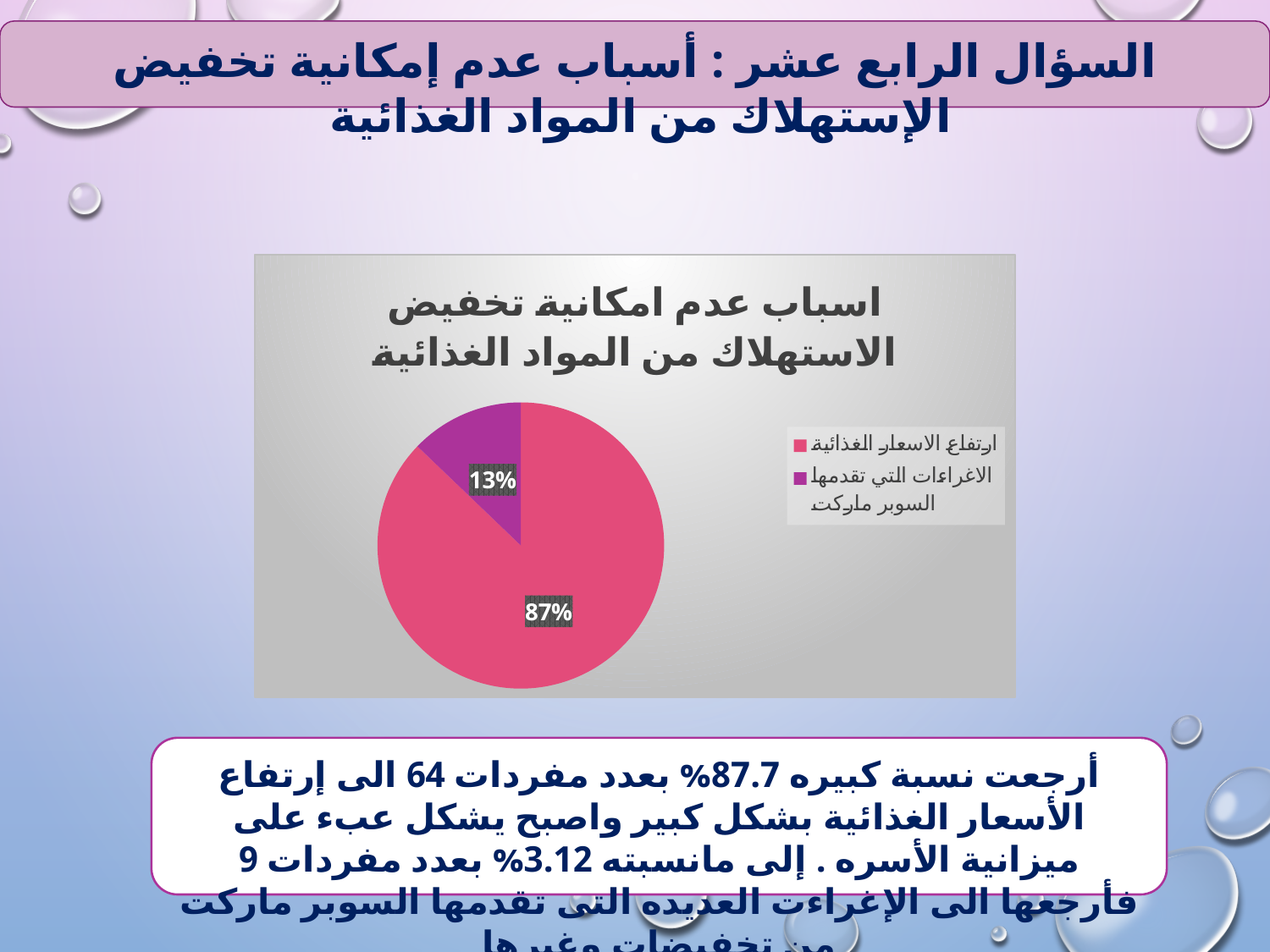
Which is larger: the slice for ارتفاع الاسعار الغذائية or the slice for الاغراءات التي تقدمها السوبر ماركت? ارتفاع الاسعار الغذائية What colour is the slice for الاغراءات التي تقدمها السوبر ماركت? Purple What share of the pie is labelled for الاغراءات التي تقدمها السوبر ماركت? 13% What is the title of the chart? اسباب عدم امكانية تخفيض الاستهلاك من المواد الغذائية What is the difference in percentage points between the two slices of the pie? 74 How many entries does the chart legend list? 2 Is the share for ارتفاع الاسعار الغذائية greater or less than 50%? greater Which category has the largest slice of the pie? ارتفاع الاسعار الغذائية What share of the pie is labelled for ارتفاع الاسعار الغذائية? 87% How many slices does the pie chart have? 2 What kind of chart is shown on the slide? Pie chart Which category has the smallest slice of the pie? الاغراءات التي تقدمها السوبر ماركت